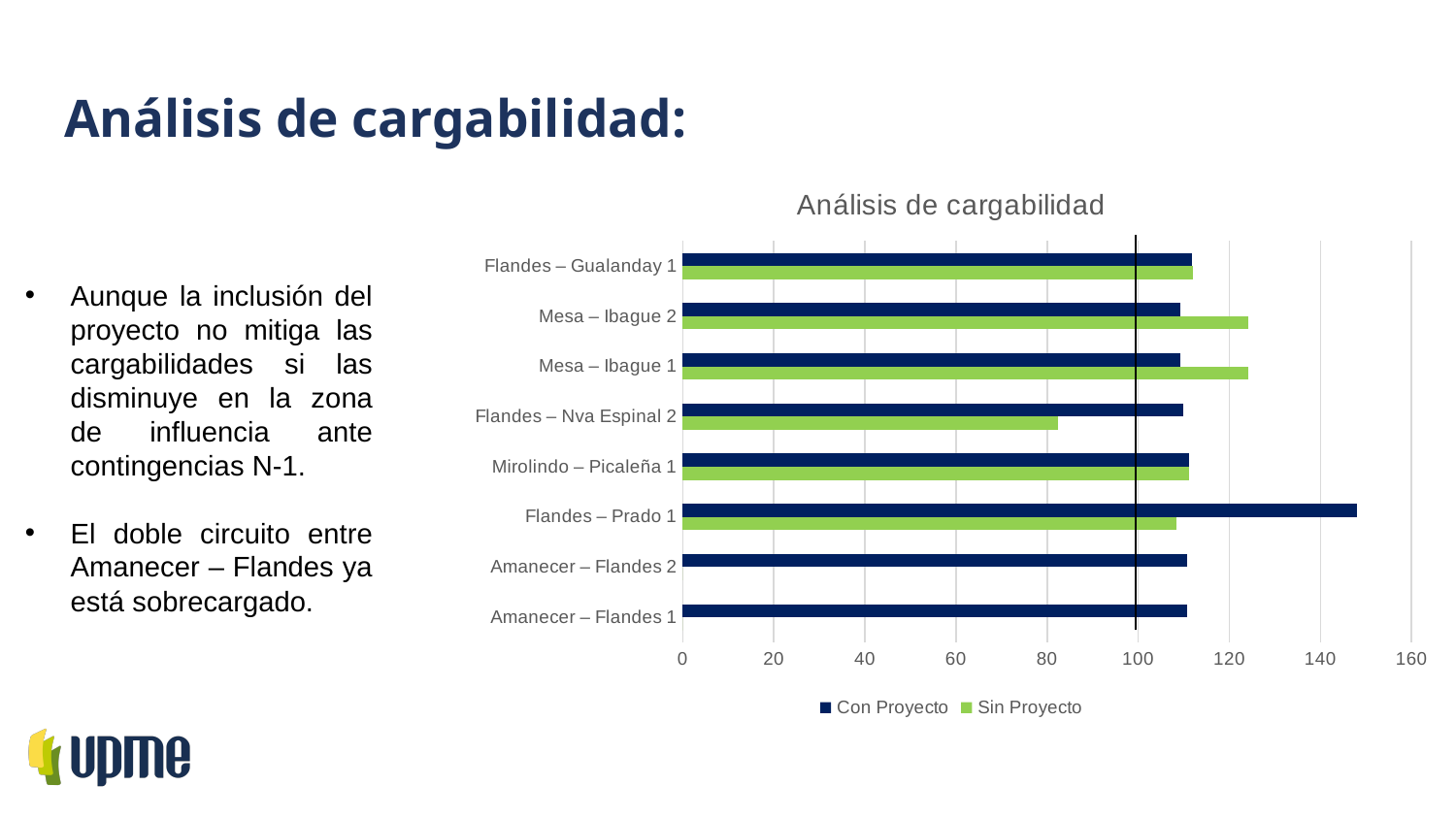
Which series is shown in green in the chart? Sin Proyecto Is the Sin Proyecto value for Mesa – Ibague 2 greater or less than 120? greater How many series does the chart legend list? 2 For Mesa – Ibague 1, which is larger: the Con Proyecto value or the Sin Proyecto value? Sin Proyecto Is the Sin Proyecto value for Flandes – Nva Espinal 2 greater or less than 100? less Is the Con Proyecto value for Flandes – Prado 1 greater or less than 140? greater Which category has the highest Con Proyecto value? Flandes – Prado 1 What is the title of the chart? Análisis de cargabilidad For Flandes – Prado 1, which is larger: the Con Proyecto value or the Sin Proyecto value? Con Proyecto How many categories are plotted on the y axis of the chart? 8 What kind of chart is shown on the slide? Bar chart